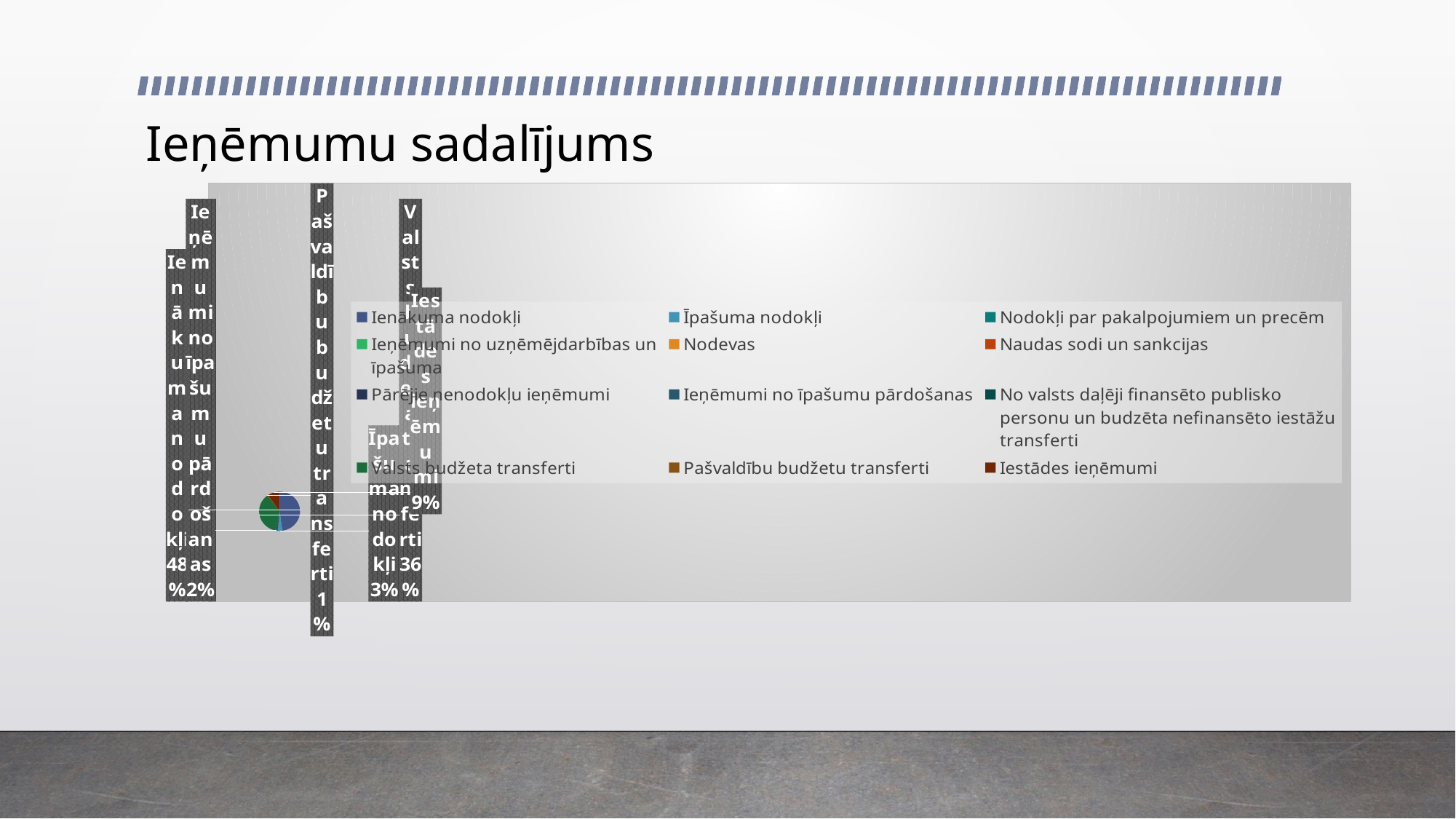
By how many percentage points does the share for Ienākuma nodokļi exceed the share for Valsts budžeta transferti? 12 What share of the pie is labelled for Iestādes ieņēmumi? 9% What is the title of the chart on the slide? Ieņēmumu sadalījums What kind of chart is shown on the slide? pie chart Which category has the largest share of the pie? Ienākuma nodokļi Which is larger, the share for Ienākuma nodokļi or the share for Valsts budžeta transferti? Ienākuma nodokļi Which legend entry is shown with a light blue marker? Īpašuma nodokļi How many entries does the chart's legend list? 12 What share of the pie is labelled for Ienākuma nodokļi? 48% What share of the pie is labelled for Valsts budžeta transferti? 36%